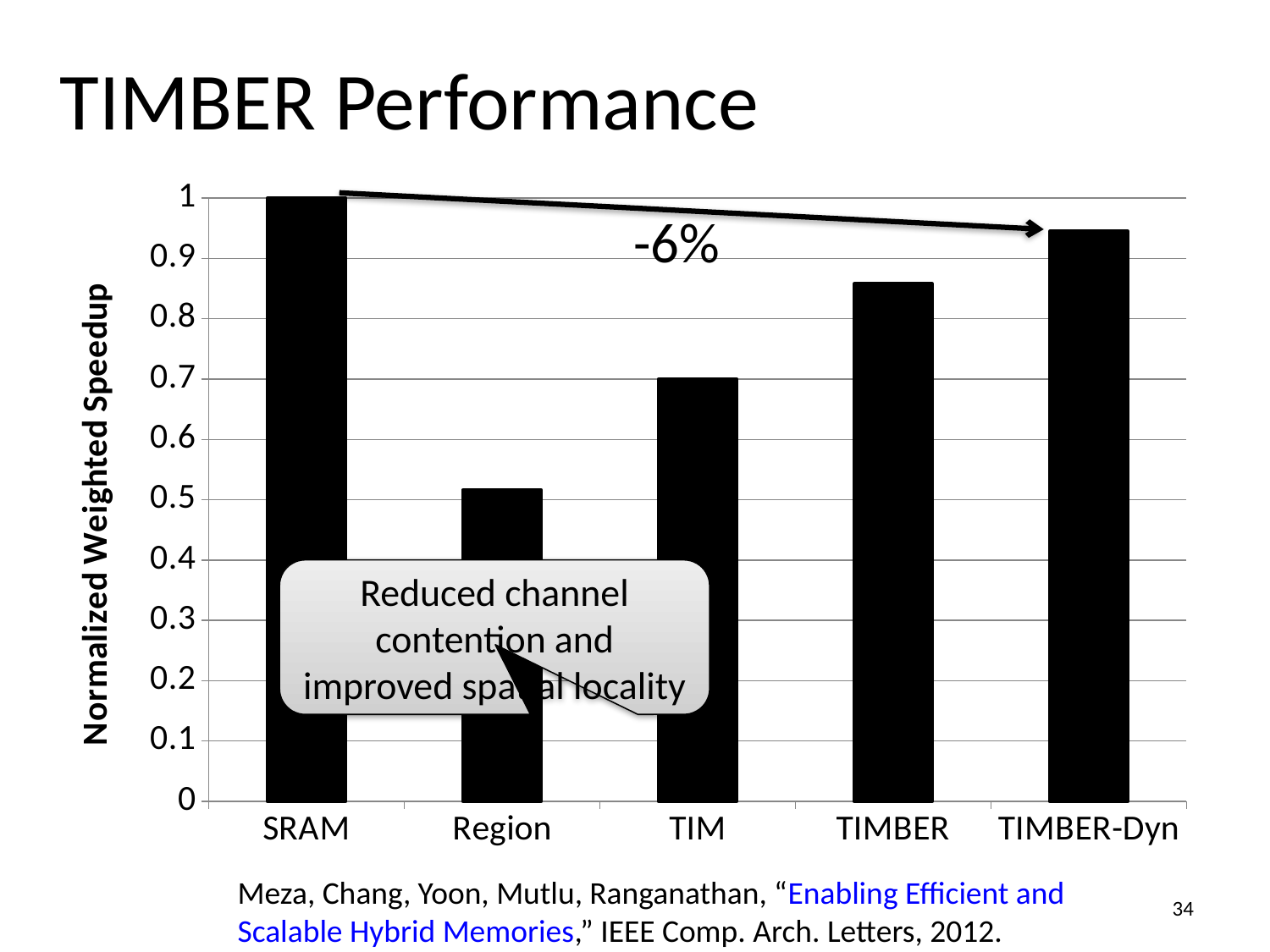
Is the value for TIMBER greater or less than 0.8? greater Which has a higher normalized weighted speedup, TIMBER or TIM? TIMBER Is the value for TIM greater or less than 0.8? less How many categories are plotted on the x axis? 5 What kind of chart is shown on the slide? bar chart What is the label of the y axis? Normalized Weighted Speedup Which has a higher normalized weighted speedup, TIMBER-Dyn or TIMBER? TIMBER-Dyn Which category has the lowest normalized weighted speedup? Region Is the value for TIMBER-Dyn greater or less than 0.9? greater Which category has the highest normalized weighted speedup? SRAM What is the normalized weighted speedup for SRAM? 1